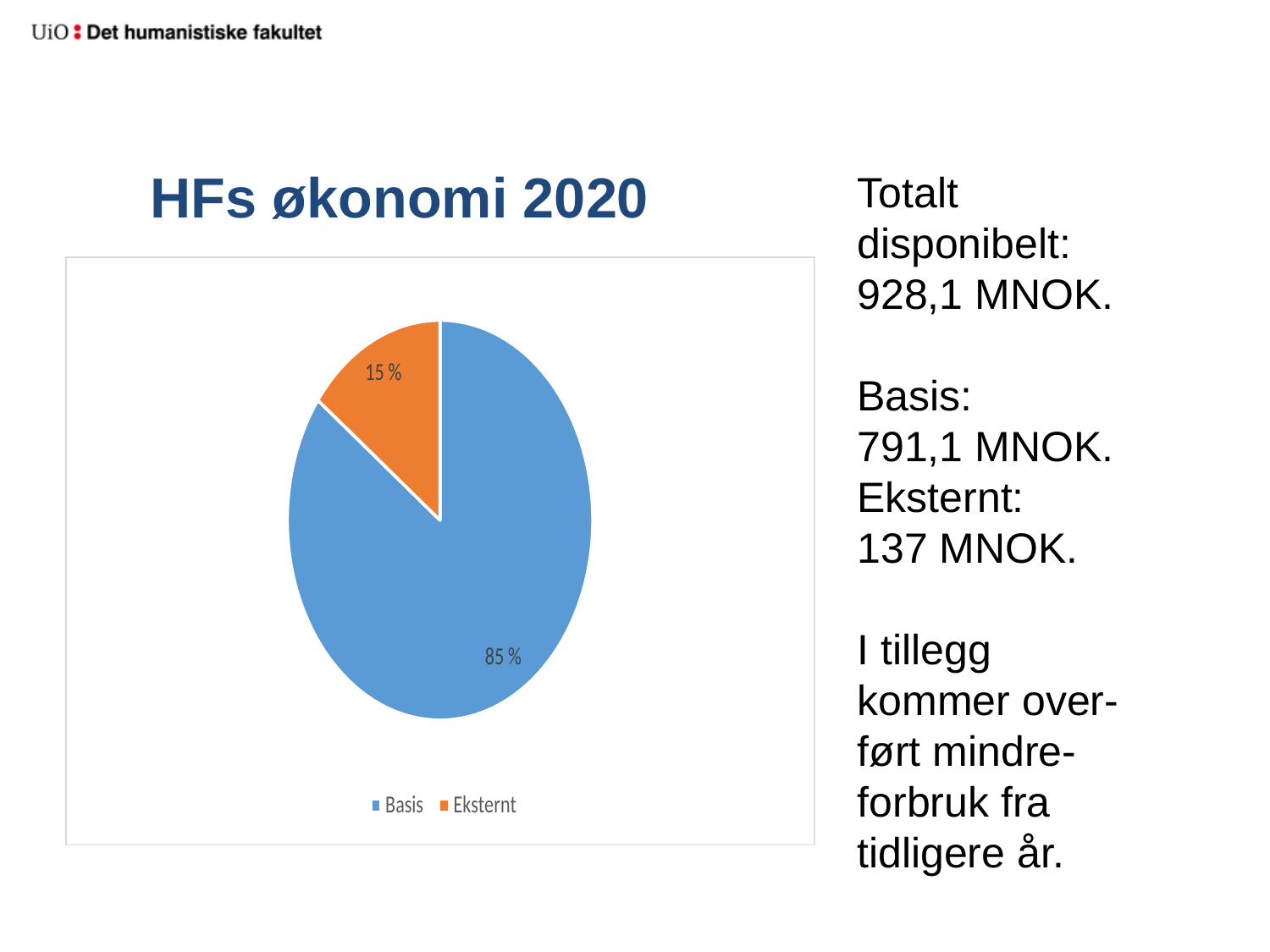
What kind of chart is shown on the slide? Pie chart What is the difference in percentage points between the Basis and Eksternt slices? 70 percentage points How many entries does the legend list? 2 Which slice of the pie is the smallest? Eksternt What is the title above the chart? HFs økonomi 2020 What share of the pie does Basis represent? 85 % What share of the pie does Eksternt represent? 15 % How many slices does the pie chart have? 2 What colour is the Eksternt slice? Orange Which slice of the pie is the largest? Basis Which is larger, the Basis slice or the Eksternt slice? Basis